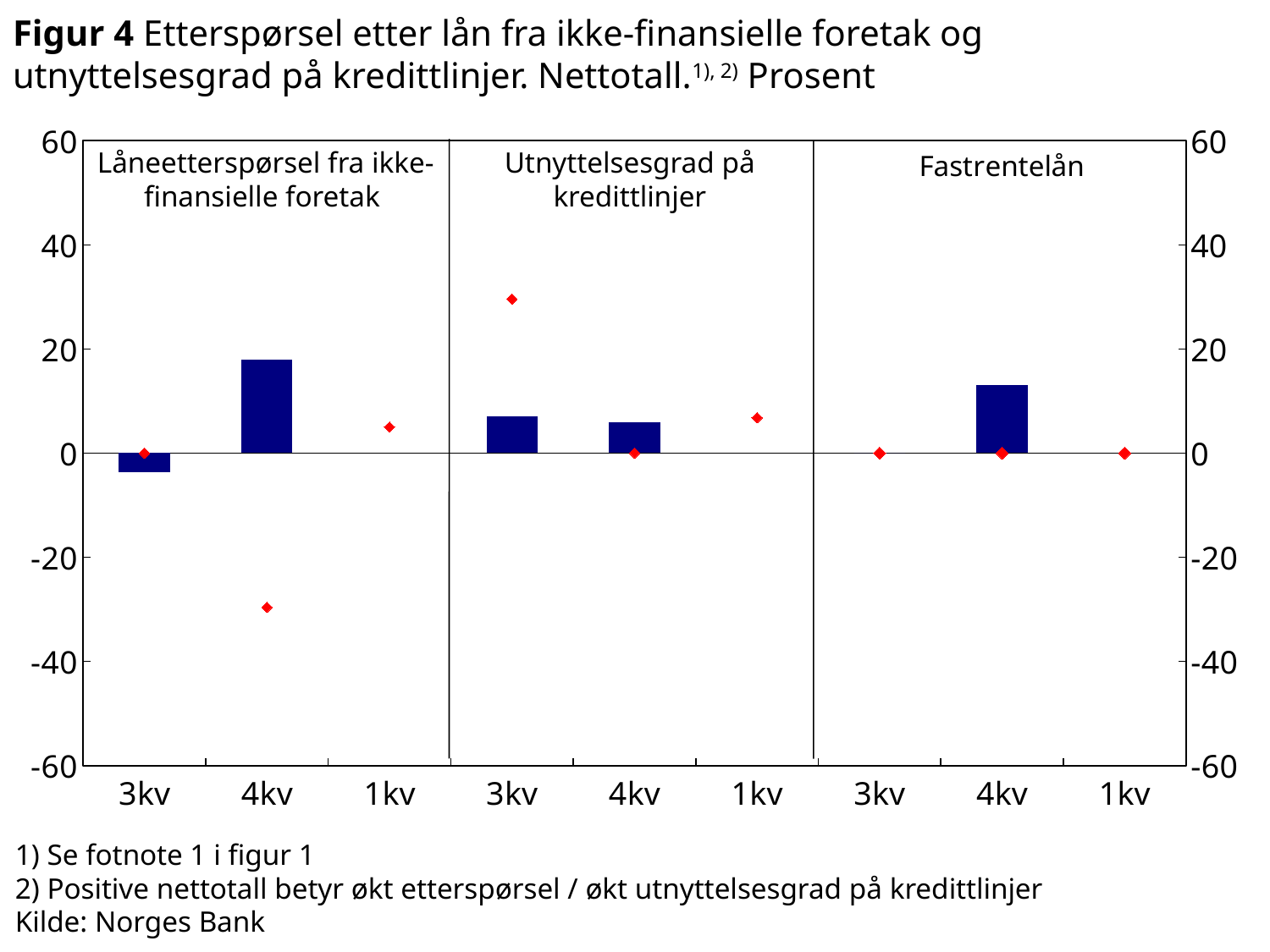
In the panel 'Låneetterspørsel fra ikke-finansielle foretak', is the bar for 3kv greater or less than 0? less In the panel 'Utnyttelsesgrad på kredittlinjer', is the red diamond for 3kv greater or less than 20? greater How many quarters are shown on the x axis of each panel? 3 Which panel has the larger bar for 4kv: 'Låneetterspørsel fra ikke-finansielle foretak' or 'Fastrentelån'? Låneetterspørsel fra ikke-finansielle foretak What kind of chart is shown in Figur 4? combination chart with bars and red diamond markers In the panel 'Låneetterspørsel fra ikke-finansielle foretak', is the bar for 4kv greater or less than 10? greater In the panel 'Fastrentelån', which quarter has the highest bar? 4kv In the panel 'Låneetterspørsel fra ikke-finansielle foretak', which quarter has the highest bar? 4kv How many panels does the chart in Figur 4 have? 3 What source is cited below the chart? Norges Bank